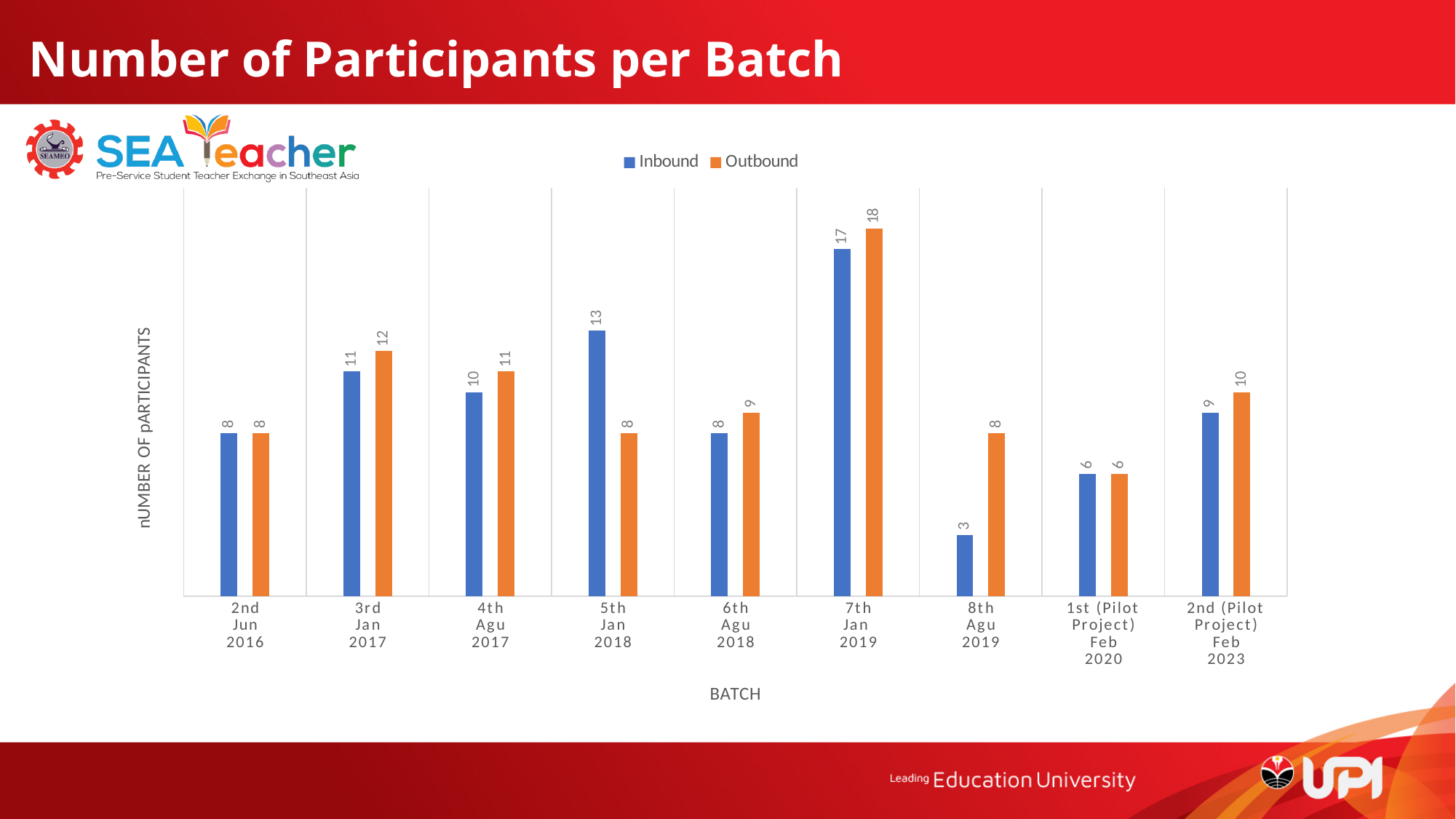
Which batch has the lowest Inbound value? 8th Agu 2019 What is the difference between the Outbound and Inbound values for the 3rd batch (Jan 2017)? 1 What kind of chart is shown on the slide? Bar chart What is the Outbound value for the 5th batch (Jan 2018)? 8 What is the Inbound value for the 7th batch (Jan 2019)? 17 Which is larger for the 6th batch (Agu 2018): Inbound or Outbound? Outbound How many series does the legend list? 2 Which batch has the highest Outbound value? 7th Jan 2019 What is the Inbound value for the 8th batch (Agu 2019)? 3 What is the difference between the Inbound values for the 7th batch (Jan 2019) and the 8th batch (Agu 2019)? 14 What is the label of the vertical axis? nUMBER OF pARTICIPANTS How many batches are shown on the x axis? 9